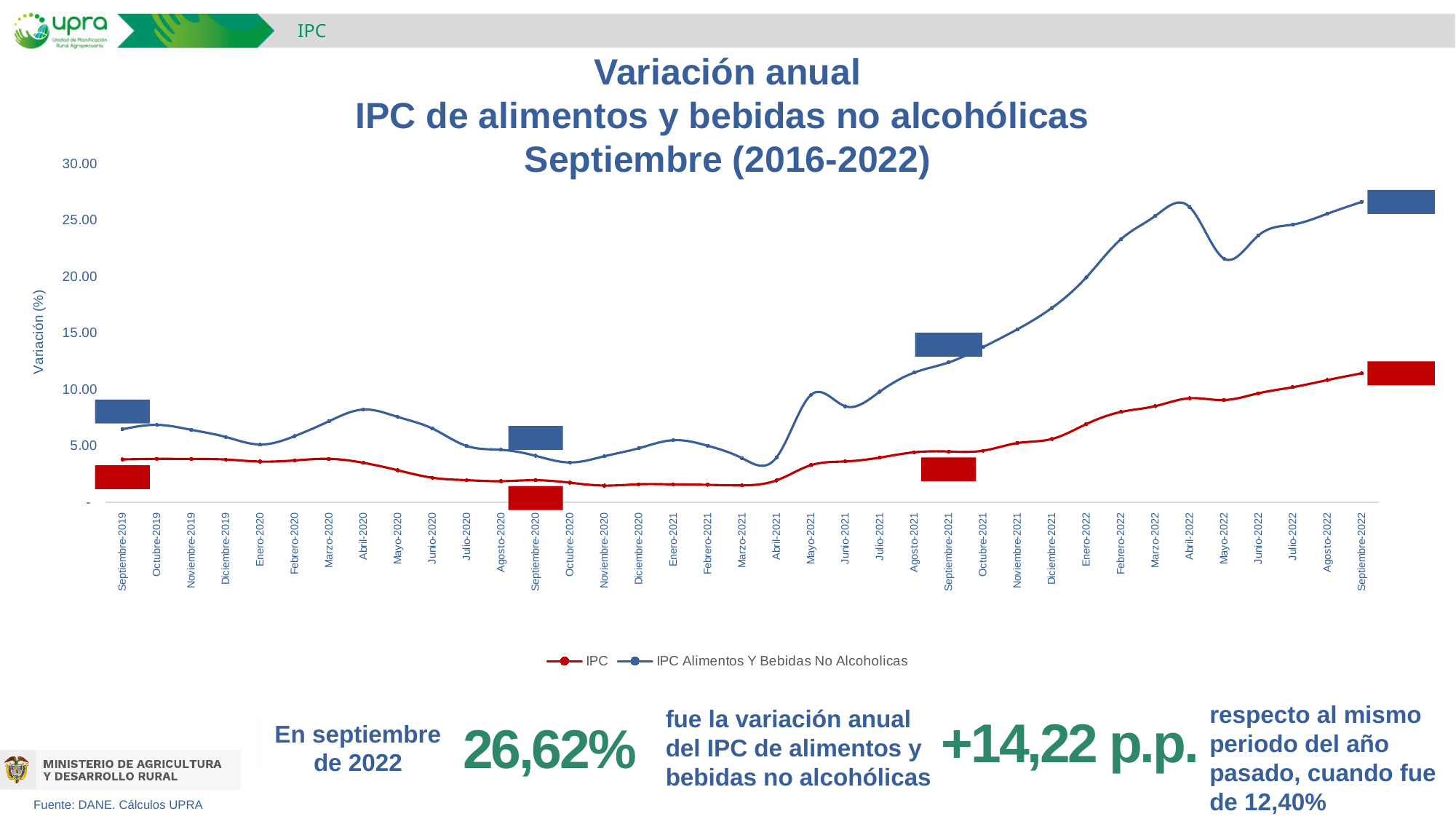
In Septiembre-2022, which series has the higher value, IPC or IPC Alimentos Y Bebidas No Alcoholicas? IPC Alimentos Y Bebidas No Alcoholicas According to the slide, what was the annual variation of the IPC de alimentos y bebidas no alcohólicas in September 2022? 26,62% According to the slide, what was the annual variation of the IPC de alimentos y bebidas no alcohólicas in September 2021? 12,40% How many months are shown along the x axis of the chart? 37 What is the label of the vertical axis of the chart? Variación (%) Is the value of the IPC Alimentos Y Bebidas No Alcoholicas series in Abril-2021 greater or less than 5.00? less Does the IPC Alimentos Y Bebidas No Alcoholicas series overall rise or fall from Septiembre-2019 to Septiembre-2022? rise How many series does the chart legend list? 2 What are the two series named in the chart legend? IPC; IPC Alimentos Y Bebidas No Alcoholicas What kind of chart is shown on the slide? line chart Is the value of the IPC series in Septiembre-2022 greater or less than 10.00? greater By how many percentage points did the annual variation of the IPC de alimentos y bebidas no alcohólicas in September 2022 exceed that of September 2021? +14,22 p.p.